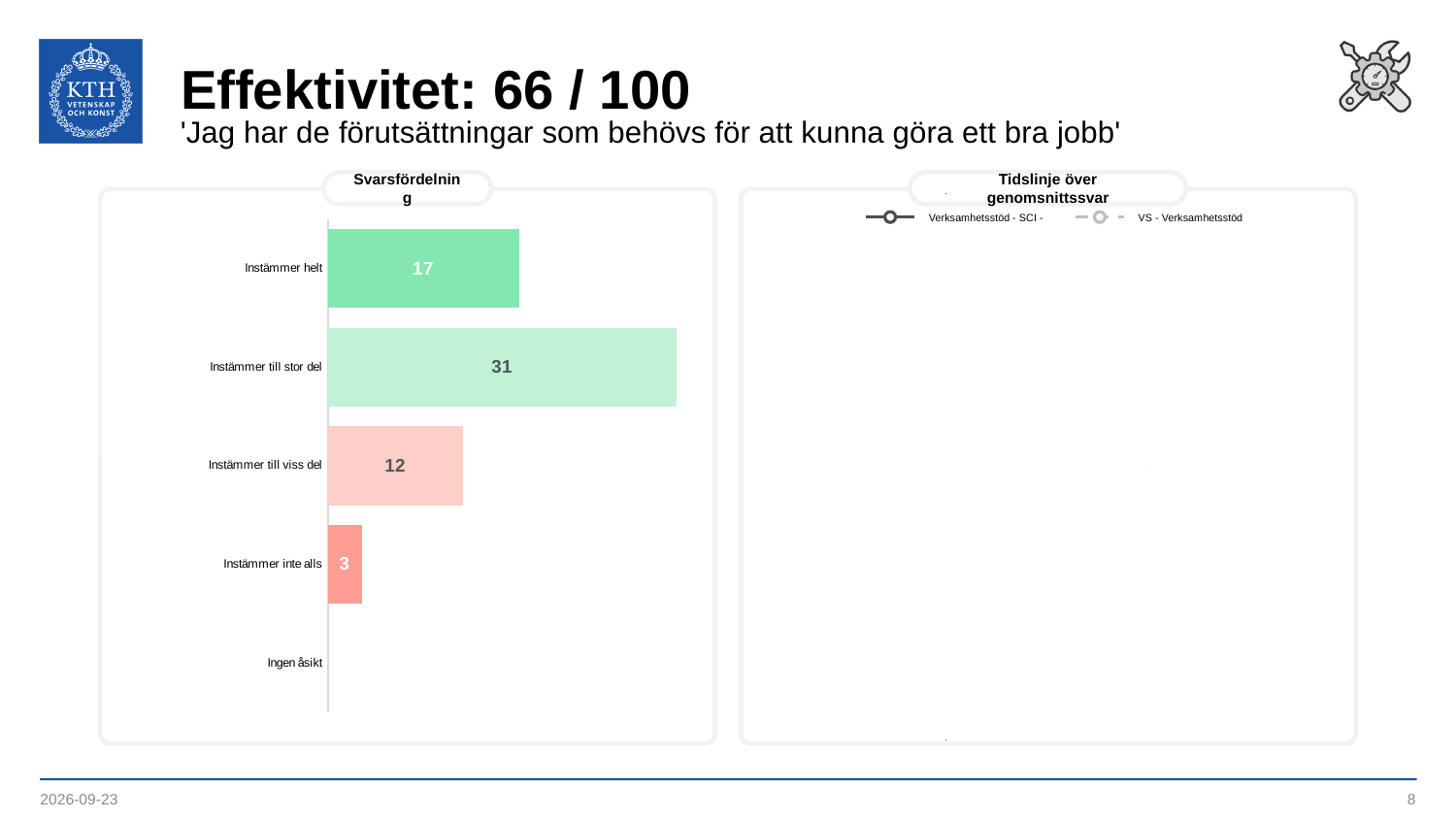
How many categories are listed on the axis of the Svarsfördelning chart? 5 In the Svarsfördelning chart, what is the value for 'Instämmer till stor del'? 31 In the Svarsfördelning chart, what is the value for 'Instämmer till viss del'? 12 How many series does the legend of the 'Tidslinje över genomsnittssvar' chart list? 2 In the Svarsfördelning chart, what is the value for 'Instämmer inte alls'? 3 In the Svarsfördelning chart, which category has the highest value? Instämmer till stor del In the Svarsfördelning chart, what is the value for 'Instämmer helt'? 17 What is the title of the chart on the left side of the slide? Svarsfördelning In the Svarsfördelning chart, which is larger: 'Instämmer helt' or 'Instämmer till viss del'? Instämmer helt What kind of chart is the Svarsfördelning chart? Bar chart In the Svarsfördelning chart, what is the difference between 'Instämmer till viss del' and 'Instämmer inte alls'? 9 In the Svarsfördelning chart, what is the difference between 'Instämmer till stor del' and 'Instämmer helt'? 14